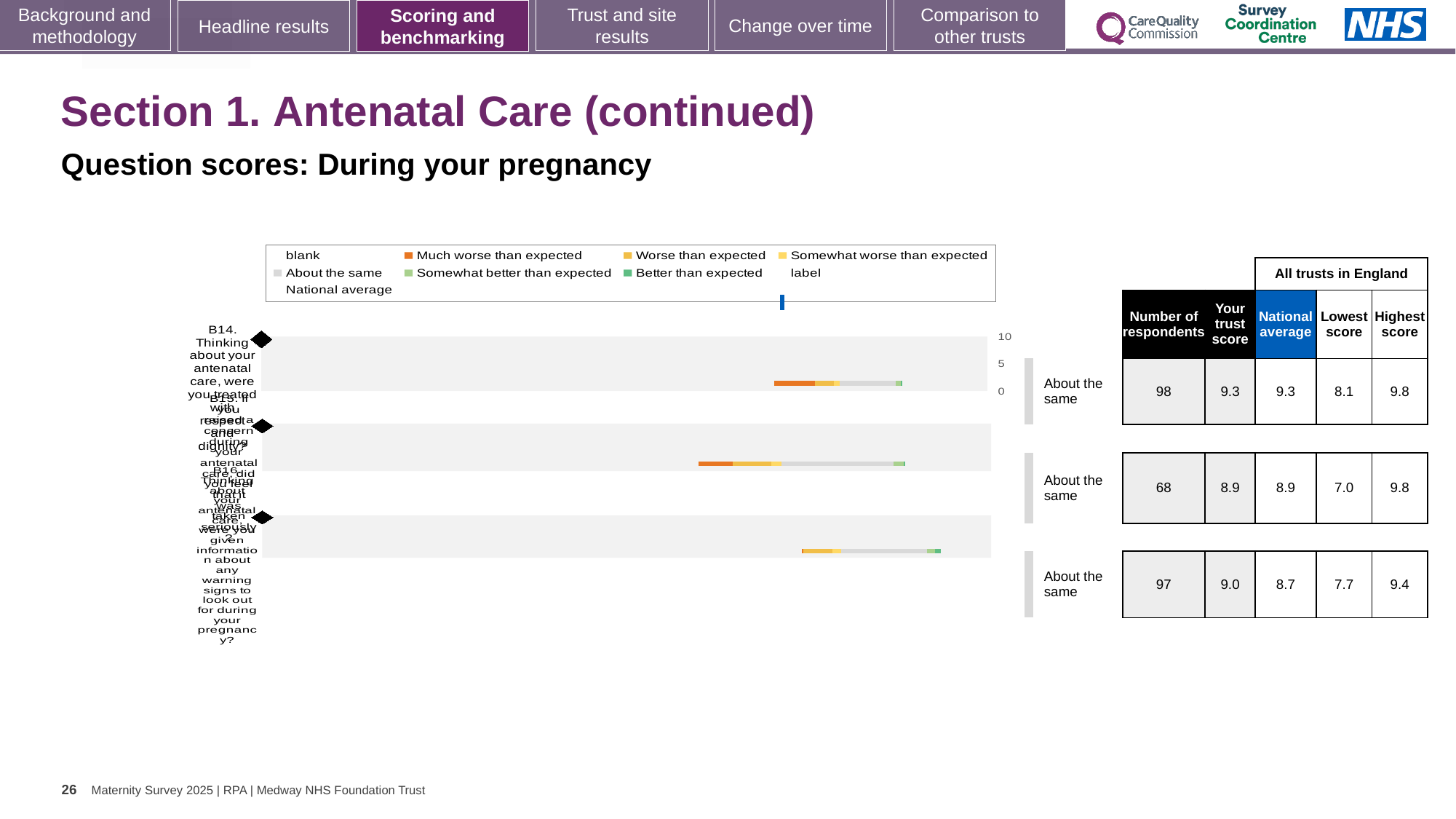
What kind of chart is shown on the slide? bar chart What benchmark category is shown for each of the three questions? About the same In the table, what is the trust score for the second row (B15)? 8.9 In the table, what is the lowest score for the second row (B15)? 7.0 What is the difference between the trust score and the national average for the third row (B16)? 0.3 Which colour in the legend represents 'Much worse than expected'? orange Which row in the table has the fewest respondents? the second row (B15), 68 How many questions (bars) are plotted in the chart? 3 In the table, what is the highest score for the third row (B16)? 9.4 Is the trust score for the first row (B14) larger or smaller than the trust score for the second row (B15)? larger In the table, what is the number of respondents for the first row (B14)? 98 In the table, what is the national average for the third row (B16)? 8.7